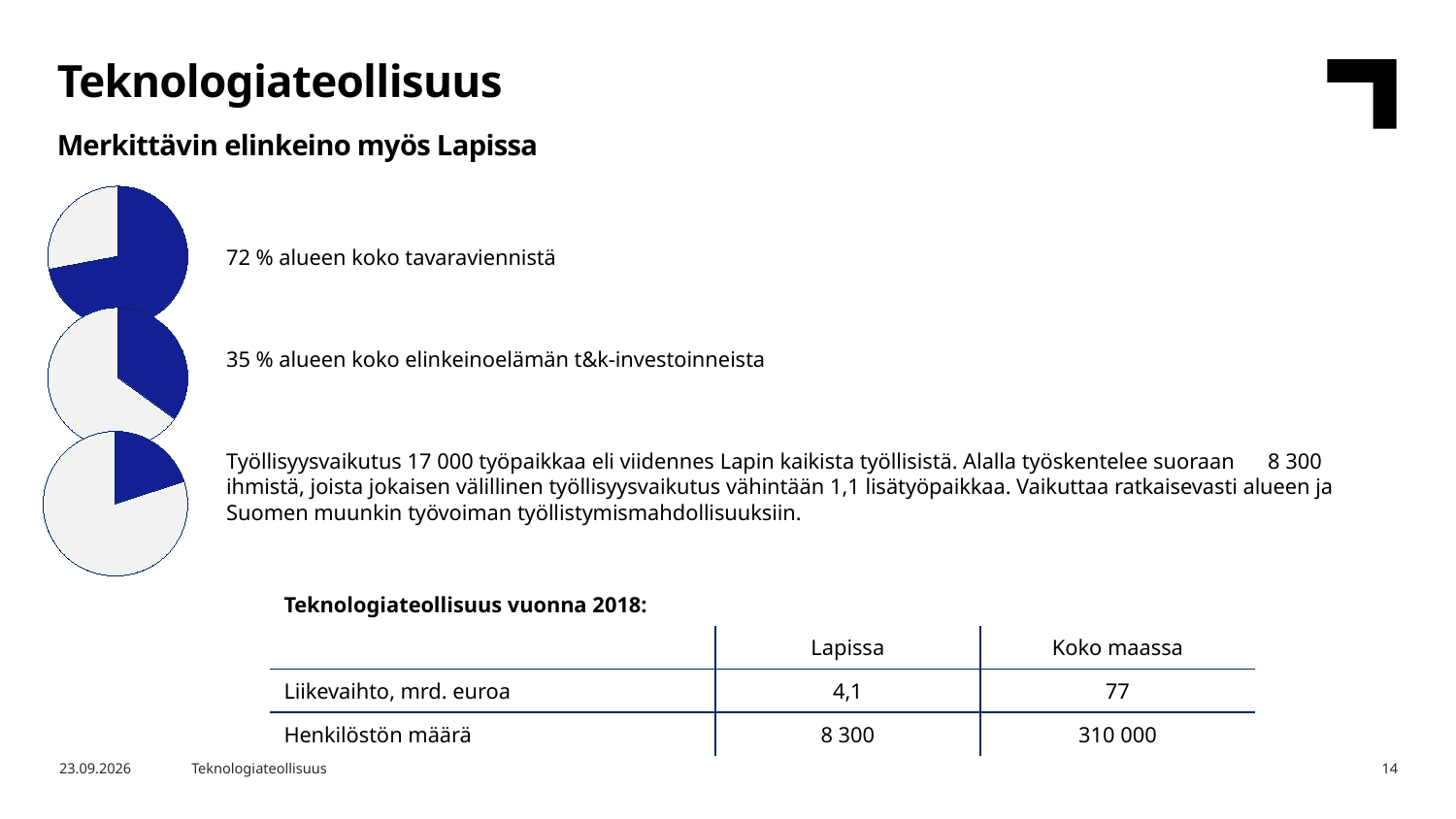
In the middle pie chart, what share of the region's business R&D investments does the blue slice represent? 35 % In the top pie chart, what share of the region's total goods exports does the blue slice represent? 72 % What colour is the highlighted slice in each pie chart? Blue Is the blue slice in the bottom pie chart greater or less than half of the pie? less Is the blue slice in the middle pie chart larger or smaller than the blue slice in the bottom pie chart? larger What is the difference between the shares shown by the top and middle pie charts? 37 % How many slices does each pie chart have? 2 What kind of charts are shown on the left side of the slide? Pie charts Which of the three pie charts has the smallest blue slice? The bottom pie chart Is the blue slice in the top pie chart greater or less than half of the pie? greater Which of the three pie charts has the largest blue slice? The top pie chart How many pie charts are on the slide? 3